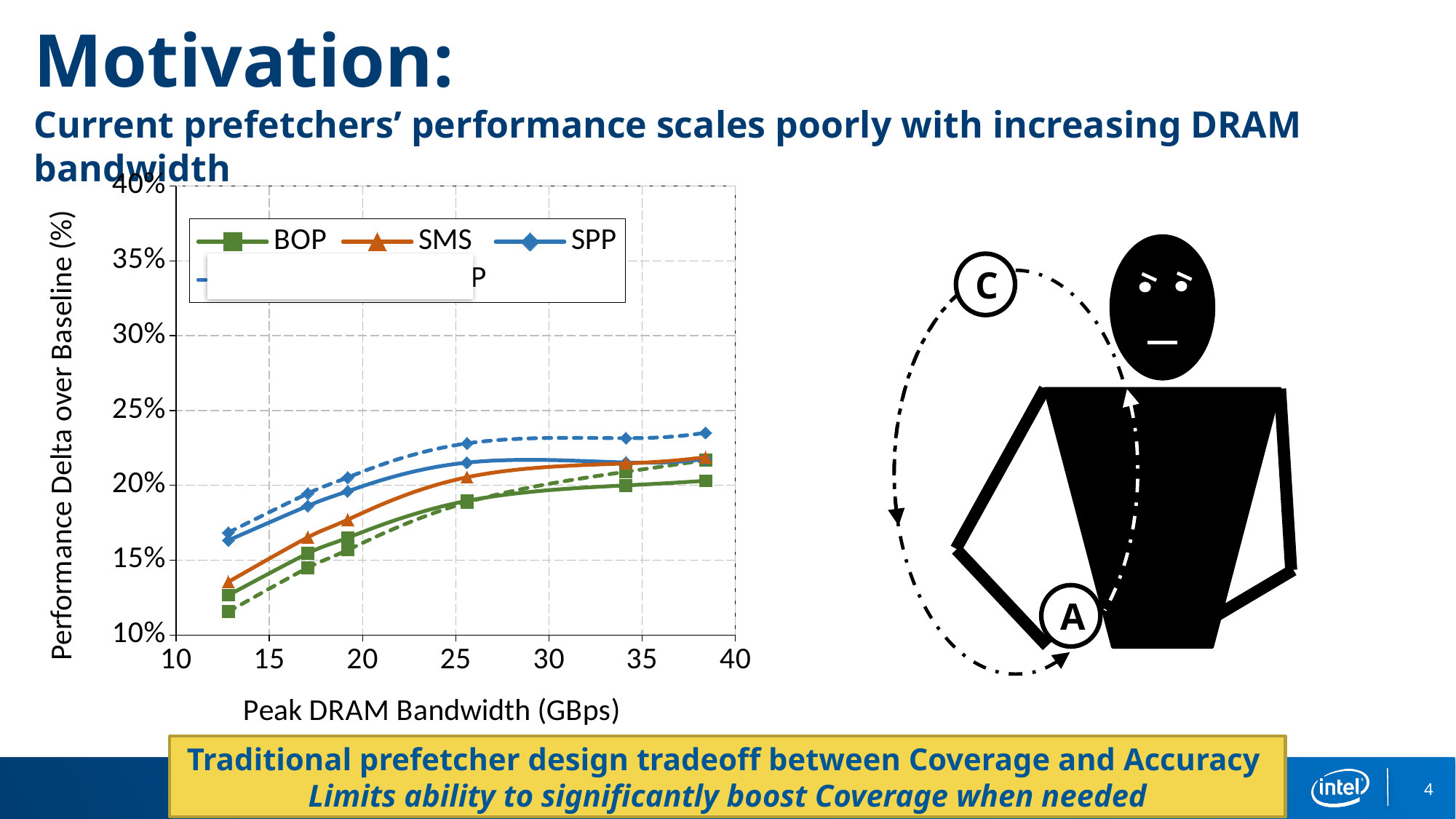
Is the value for the solid SPP line at the highest plotted bandwidth greater or less than 20%? greater Do the plotted values generally rise or fall as Peak DRAM Bandwidth increases? Rise What kind of chart is shown on the slide? Line chart Is the value for the solid BOP line at the lowest plotted bandwidth greater or less than 15%? less What is the title of the x axis of the chart? Peak DRAM Bandwidth (GBps) How many data points are plotted on the solid SPP line? 6 What is the title of the y axis of the chart? Performance Delta over Baseline (%) At the highest plotted bandwidth, which solid line is higher: SMS or BOP? SMS Is the value for the solid SPP line at the lowest plotted bandwidth greater or less than 15%? greater